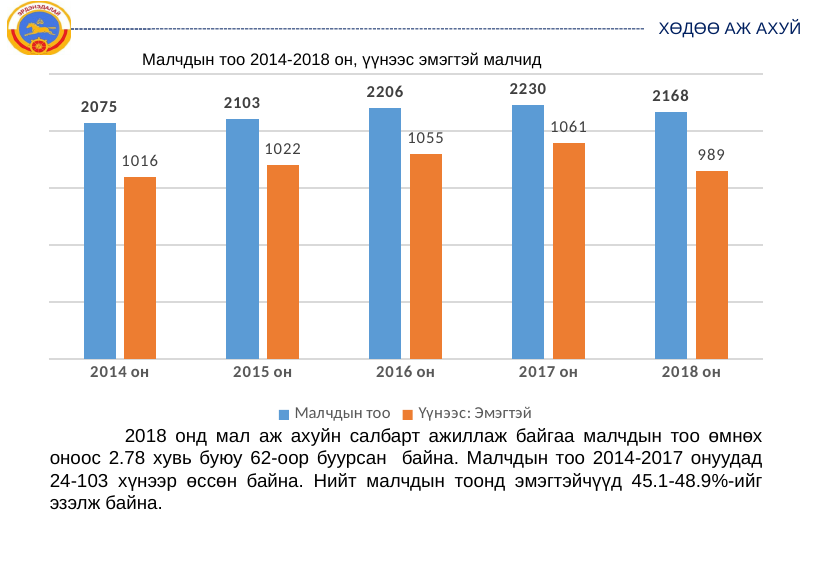
Which is larger: Үүнээс: Эмэгтэй in 2016 он or in 2015 он? 2016 он Which year has the highest value for Малчдын тоо? 2017 он What is the value of Малчдын тоо for 2017 он? 2230 What is the difference between Малчдын тоо in 2017 он and 2018 он? 62 What is the title of the chart? Малчдын тоо 2014-2018 он, үүнээс эмэгтэй малчид Does the value of Малчдын тоо rise or fall from 2014 он to 2017 он? Rise What is the value of Малчдын тоо for 2014 он? 2075 How many series does the legend list? 2 What kind of chart is shown on the slide? Bar chart What is the value of Үүнээс: Эмэгтэй for 2018 он? 989 Which year has the lowest value for Үүнээс: Эмэгтэй? 2018 он How many years are shown on the x axis? 5